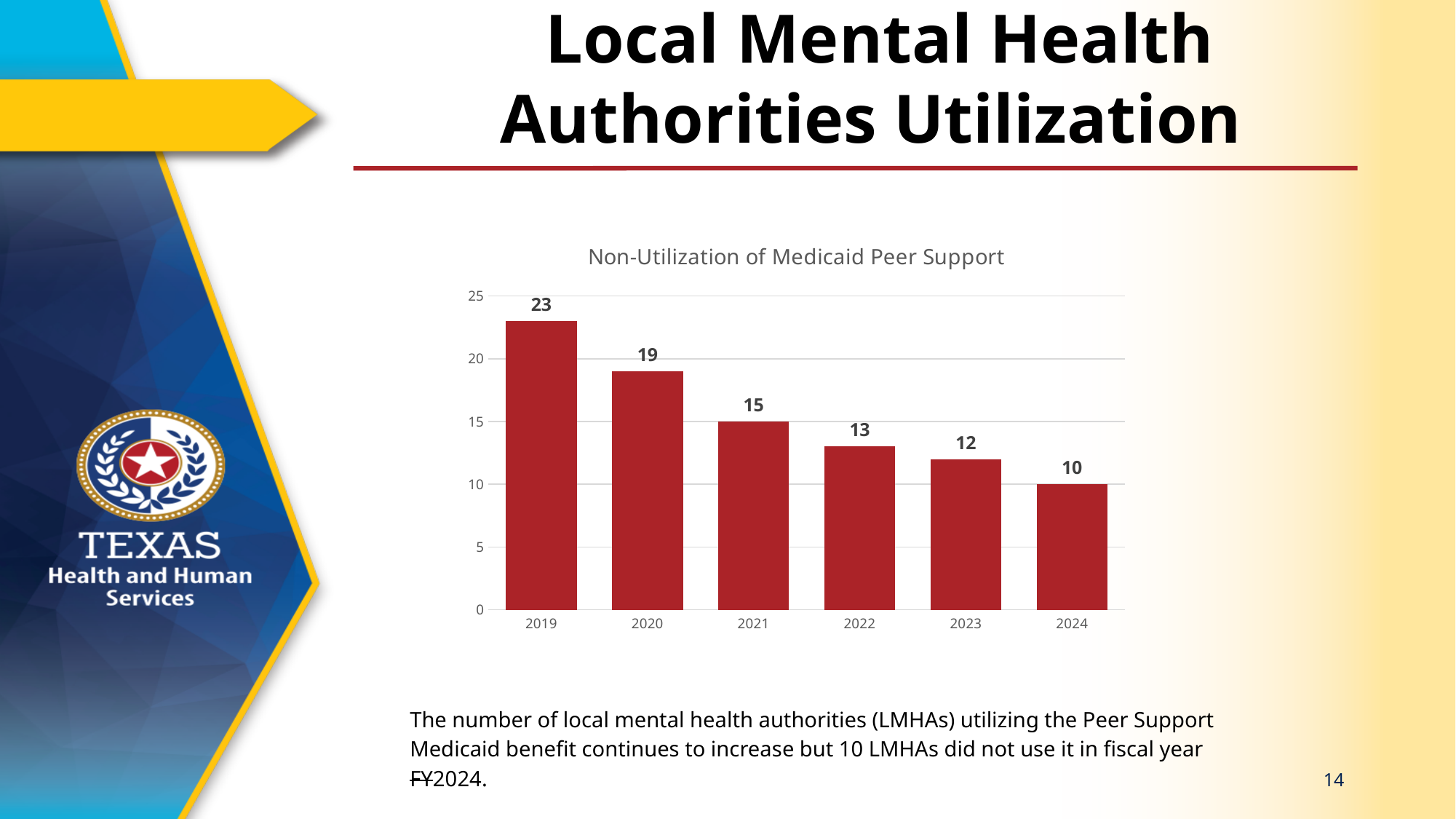
Do the values rise or fall from 2019 to 2024? fall Which is larger, the value for 2022 or the value for 2023? 2022 What is the value for 2019? 23 What is the value for 2024? 10 What is the value for 2021? 15 What is the difference between the values for 2021 and 2024? 5 What is the difference between the values for 2019 and 2020? 4 How many years are shown on the x axis? 6 Which year has the lowest value? 2024 Which year has the highest value? 2019 What kind of chart is shown? bar chart Is the value for 2020 greater or less than 15? greater